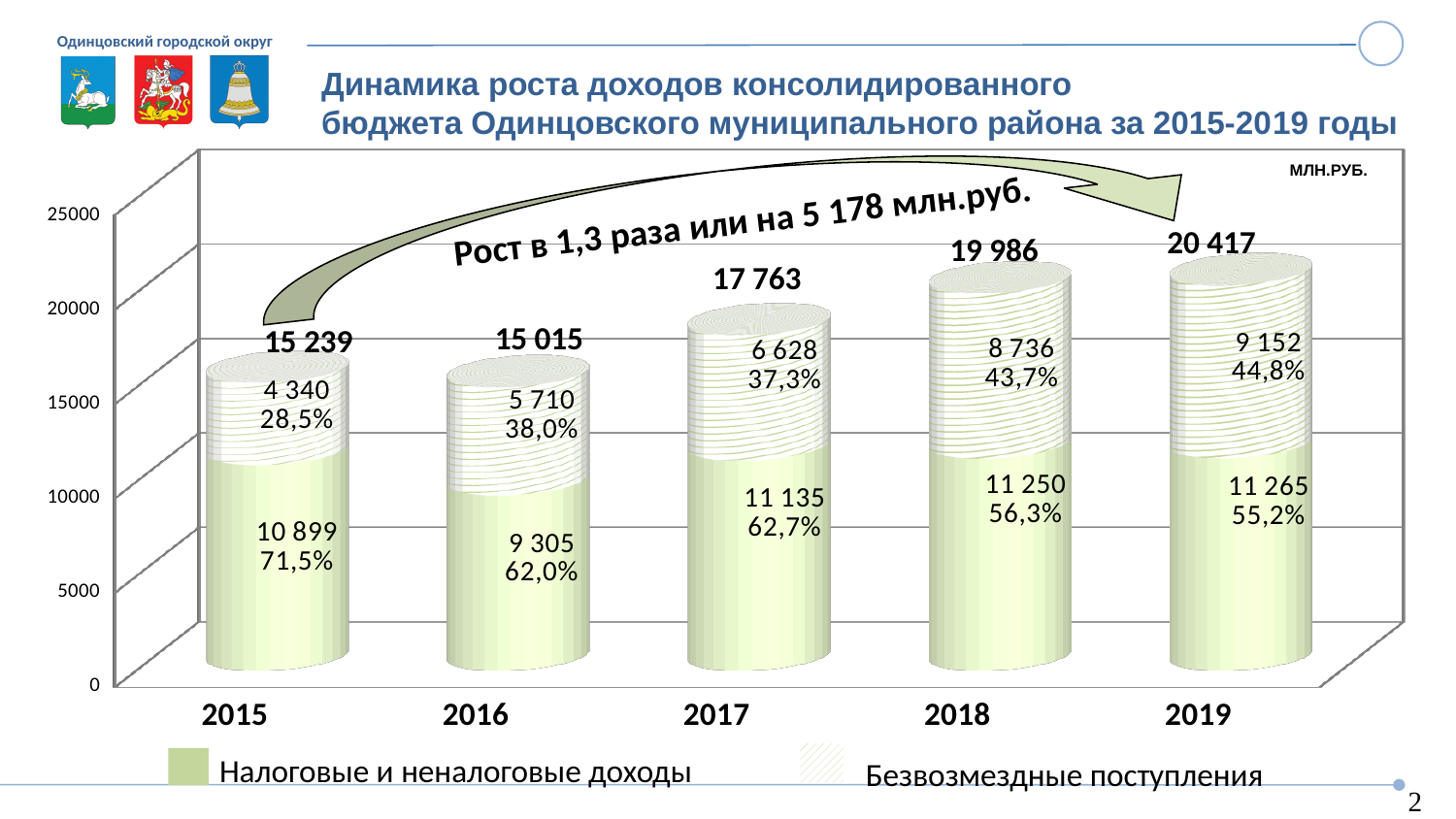
Which is larger: 'Безвозмездные поступления' in 2016 or in 2015? 2016 Which year has the highest total revenue? 2019 How many series does the legend list? 2 Which year has the lowest total revenue? 2016 What is the total consolidated budget revenue shown for 2019? 20 417 What kind of chart is shown on the slide? Stacked bar chart What is the value of 'Налоговые и неналоговые доходы' for 2016? 9 305 What percentage share do 'Безвозмездные поступления' make up in 2017? 37,3% How many years are shown on the x axis? 5 What unit of measurement is indicated in the top right corner of the chart? МЛН.РУБ. What is the value of 'Безвозмездные поступления' for 2018? 8 736 What is the difference between the total revenue in 2019 and in 2015? 5 178